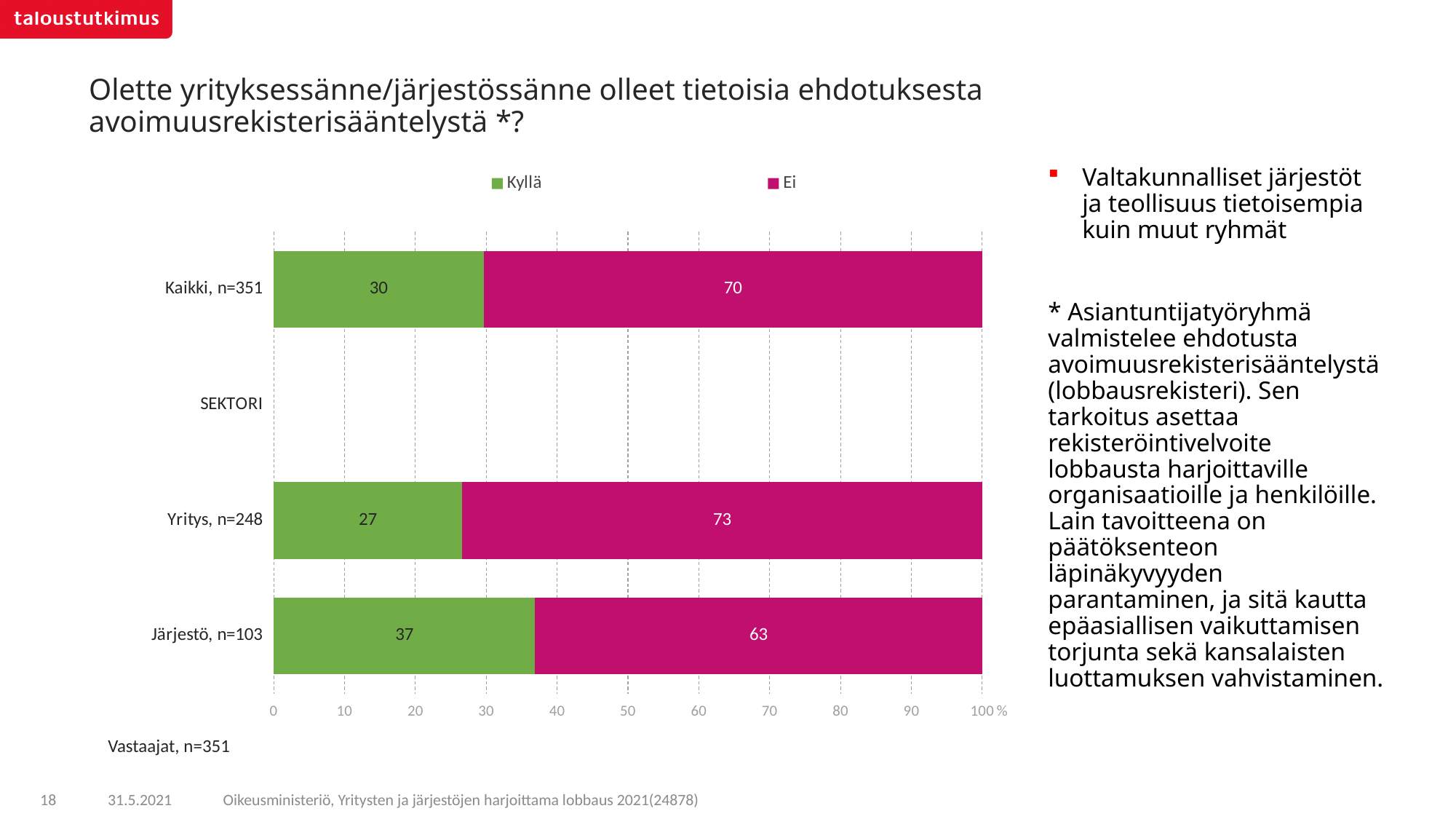
Which category has the lowest Kyllä value? Yritys, n=248 What kind of chart is shown on the slide? Stacked bar chart Is the Ei value for Kaikki, n=351 greater or less than 60? greater What is the total of the stacked bar for Yritys, n=248? 100 How many series does the legend list? 2 Which is larger: the Kyllä value for Kaikki, n=351 or the Kyllä value for Järjestö, n=103? Järjestö, n=103 Which category has the highest Kyllä value? Järjestö, n=103 What is the difference between the Ei values for Yritys, n=248 and Järjestö, n=103? 10 What is the Ei value for Yritys, n=248? 73 What is the Kyllä value for Järjestö, n=103? 37 What is the Kyllä value for Kaikki, n=351? 30 How many bars with data are plotted in the chart? 3